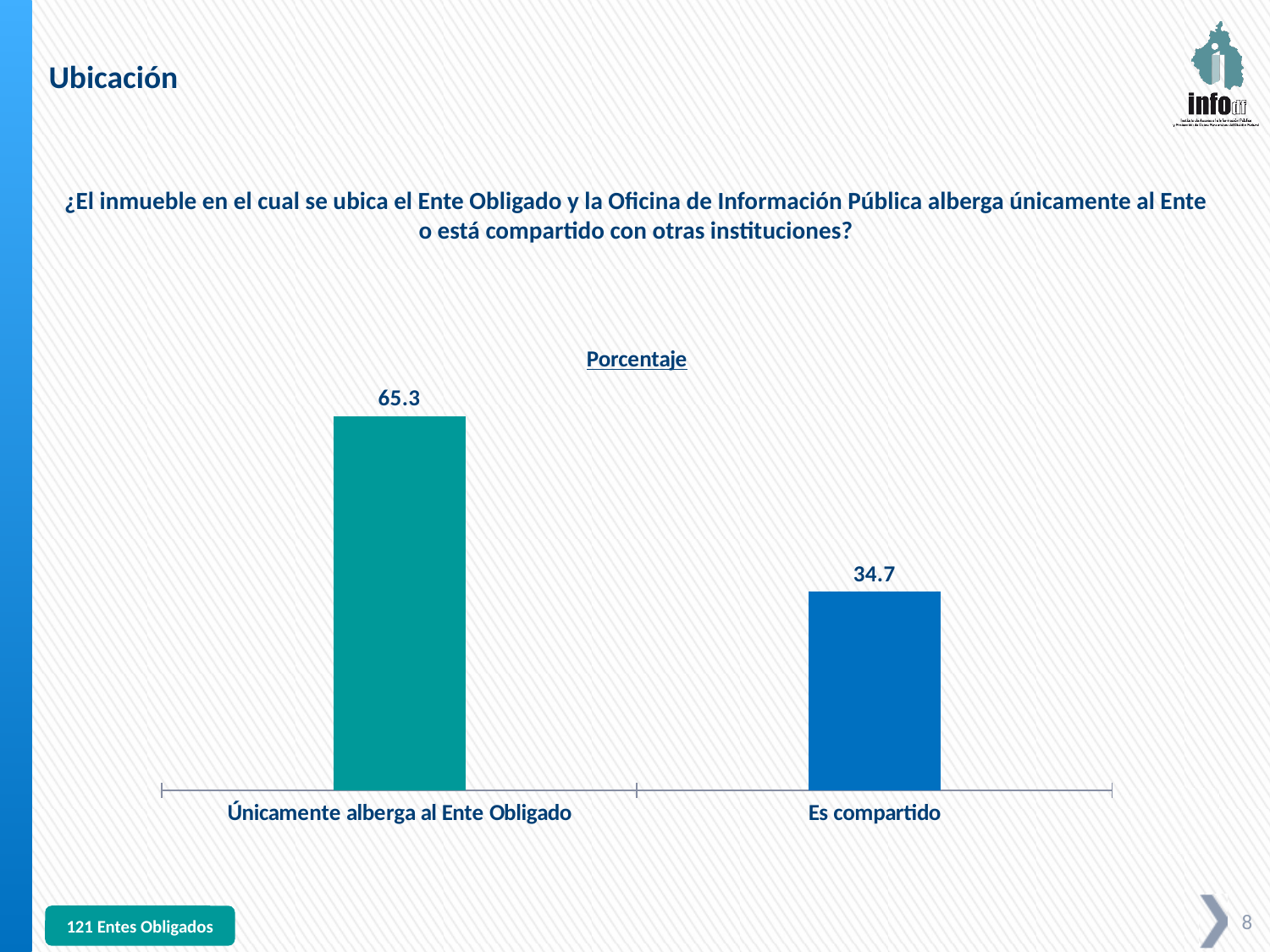
What is the value for "Es compartido"? 34.7 What colour is the bar for "Es compartido"? Blue What kind of chart is shown on the slide? Bar chart How many categories are shown in the chart? 2 Which category has the highest value? Únicamente alberga al Ente Obligado What is the value for "Únicamente alberga al Ente Obligado"? 65.3 What is the total of the two values shown in the chart? 100 Which is larger, the value for "Únicamente alberga al Ente Obligado" or the value for "Es compartido"? Únicamente alberga al Ente Obligado What is the title of the chart? Porcentaje Which category has the lowest value? Es compartido What is the difference between the values for "Únicamente alberga al Ente Obligado" and "Es compartido"? 30.6